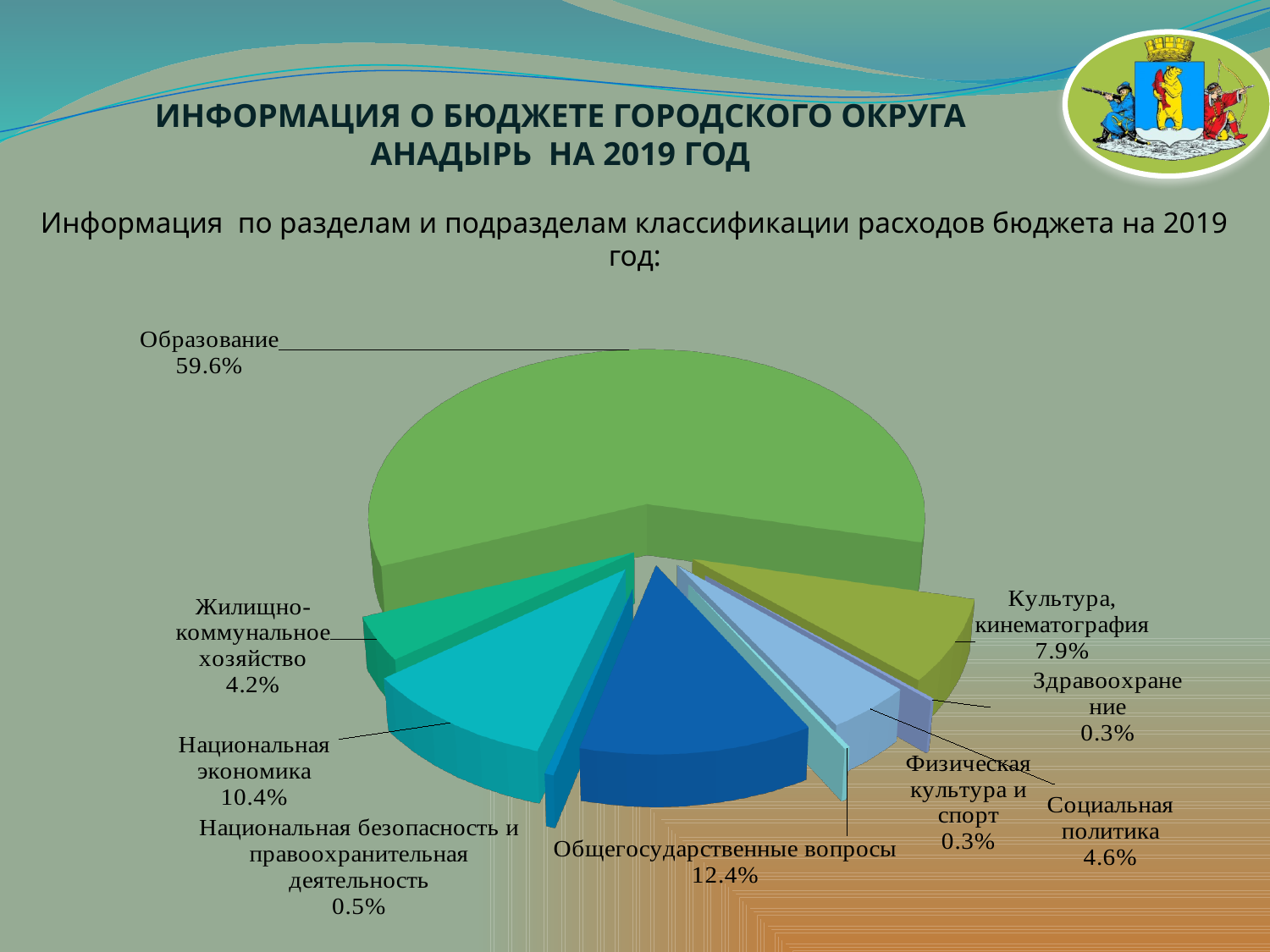
What percentage is shown for Общегосударственные вопросы? 12.4% What percentage is shown for Культура, кинематография? 7.9% What percentage is shown for Социальная политика? 4.6% What share of the budget expenditure goes to Образование? 59.6% What is the combined share of Здравоохранение and Физическая культура и спорт? 0.6% Which is larger: the share for Национальная экономика or the share for Жилищно-коммунальное хозяйство? Национальная экономика What is the difference in percentage points between Общегосударственные вопросы and Национальная экономика? 2.0% What percentage is shown for Национальная экономика? 10.4% What kind of chart is shown on the slide? Pie chart What percentage is shown for Национальная безопасность и правоохранительная деятельность? 0.5% Which category has the largest share of the pie? Образование How many categories are shown in the pie chart? 9